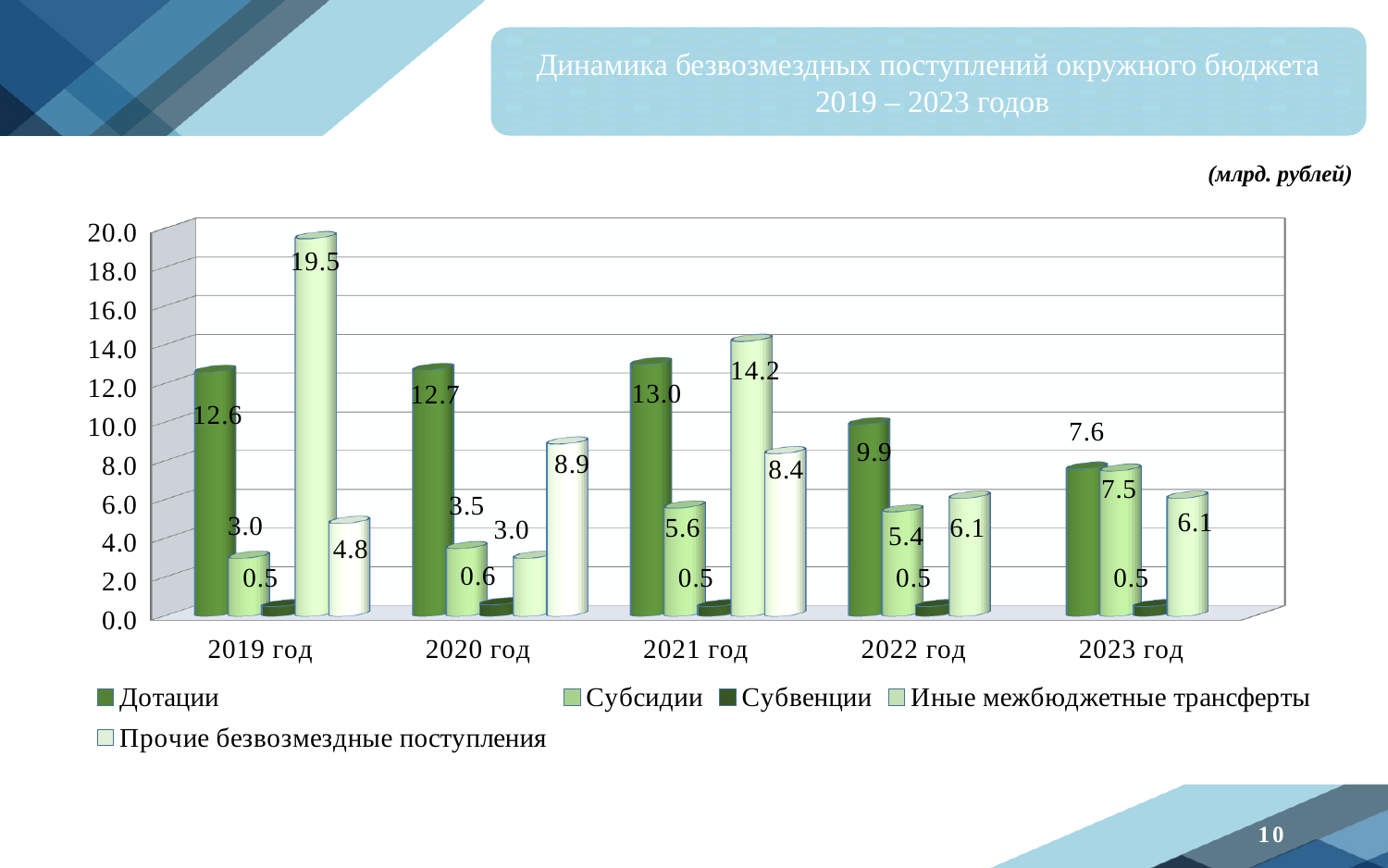
What is the difference between the Дотации values for 2019 год and 2023 год? 5.0 What is the value for Иные межбюджетные трансферты in 2021 год? 14.2 Which year has the highest value for Дотации? 2021 год What kind of chart is shown on the slide? bar chart How many years (categories) are shown on the x axis? 5 What is the highest value shown on the chart, and for which series and year? 19.5, Иные межбюджетные трансферты, 2019 год What is the value for Прочие безвозмездные поступления in 2020 год? 8.9 What is the value for Дотации in 2019 год? 12.6 How many series does the legend list? 5 Do the values for Субсидии rise or fall from 2019 год to 2023 год? rise Which is larger: Субсидии in 2021 год or Субсидии in 2022 год? 2021 год Which year has the lowest value for Дотации? 2023 год